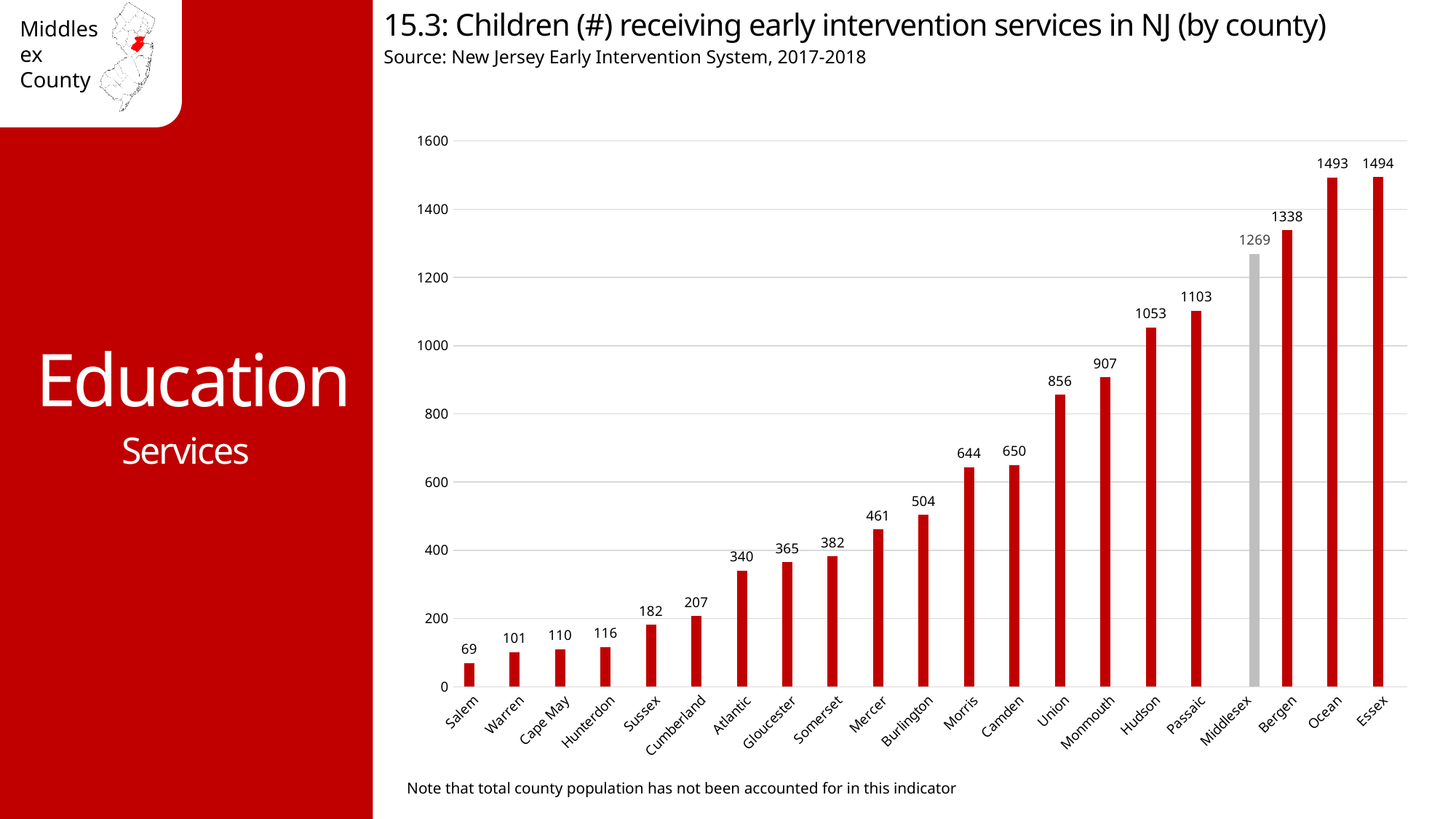
What is the value shown for Cumberland County? 207 What kind of chart is shown on the slide? Bar chart How many counties are shown on the chart? 21 Is the value for Passaic greater or less than 1000? greater What is the value shown for Hudson County? 1053 What is the difference between the values for Bergen and Middlesex? 69 How many children received early intervention services in Middlesex County? 1269 What is the difference between the values for Passaic and Hudson? 50 Which has a larger value, Union or Monmouth? Monmouth Do the values rise or fall moving from left to right along the x axis? Rise Which county's bar is shown in grey instead of red? Middlesex Which county has the lowest number of children receiving early intervention services? Salem